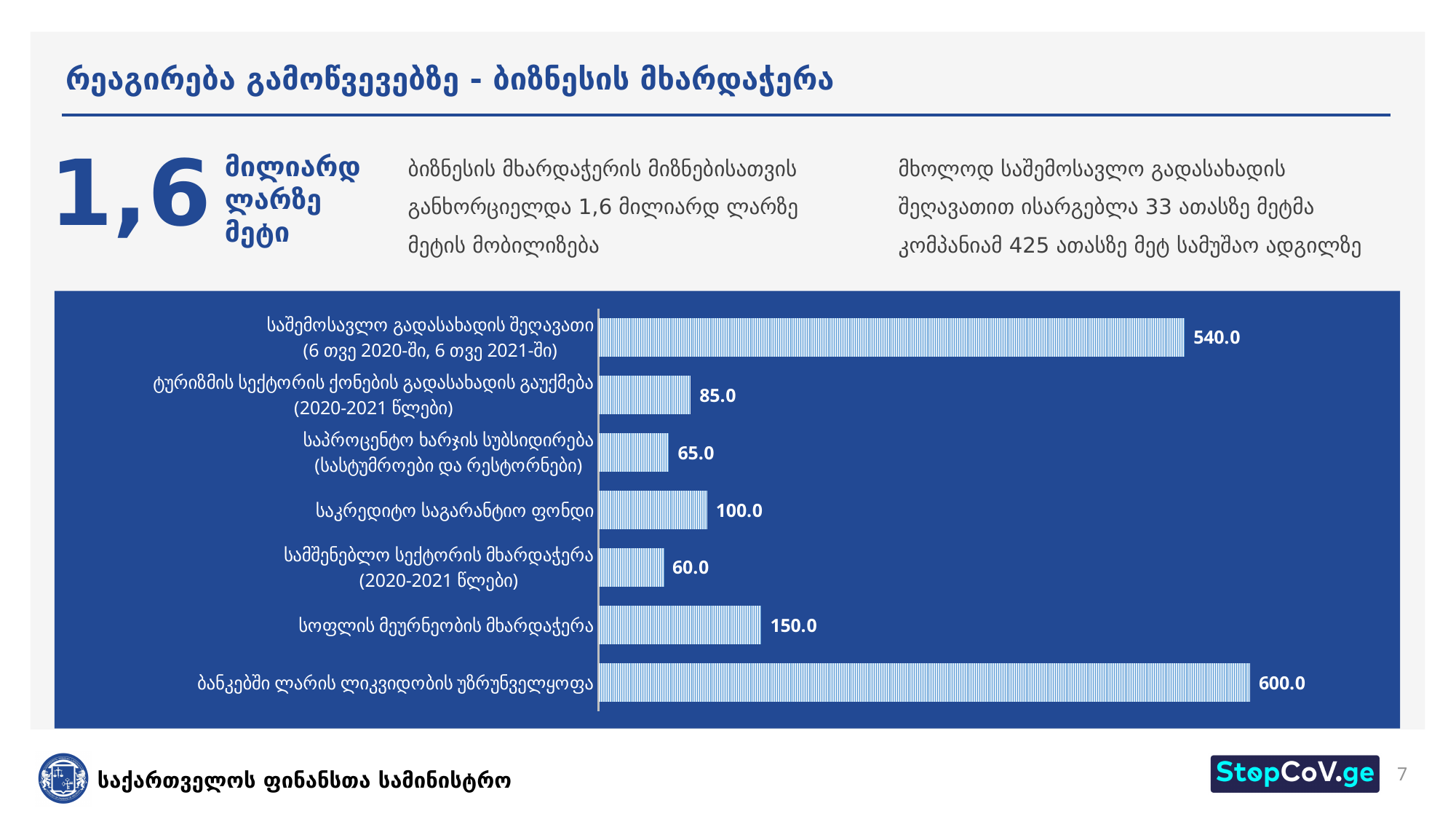
Which category has the highest value? ბანკებში ლარის ლიკვიდობის უზრუნველყოფა What is the difference between the values for ბანკებში ლარის ლიკვიდობის უზრუნველყოფა and საშემოსავლო გადასახადის შეღავათი? 60.0 Which is larger: the value for ტურიზმის სექტორის ქონების გადასახადის გაუქმება or the value for საპროცენტო ხარჯის სუბსიდირება? ტურიზმის სექტორის ქონების გადასახადის გაუქმება What kind of chart is shown on the slide? bar chart Which category has the lowest value? სამშენებლო სექტორის მხარდაჭერა (2020-2021 წლები) How many categories are shown in the chart? 7 What is the value for საშემოსავლო გადასახადის შეღავათი (6 თვე 2020-ში, 6 თვე 2021-ში)? 540.0 What is the difference between the values for სოფლის მეურნეობის მხარდაჭერა and საკრედიტო საგარანტიო ფონდი? 50.0 What is the value for საკრედიტო საგარანტიო ფონდი? 100.0 What is the value for საპროცენტო ხარჯის სუბსიდირება (სასტუმროები და რესტორნები)? 65.0 What is the value for ტურიზმის სექტორის ქონების გადასახადის გაუქმება (2020-2021 წლები)? 85.0 What is the value for სოფლის მეურნეობის მხარდაჭერა? 150.0